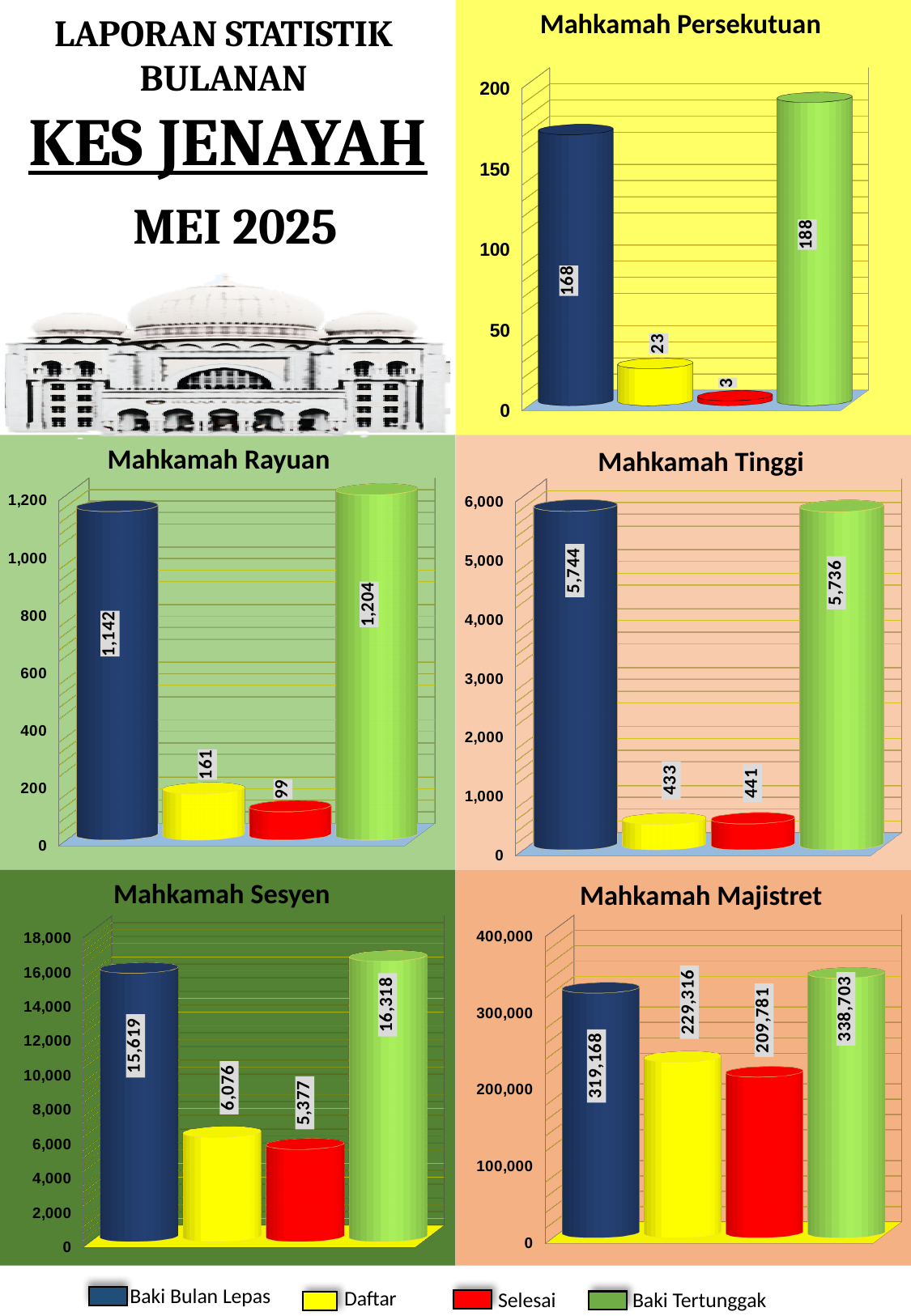
In the Mahkamah Tinggi chart, what is the value for Baki Bulan Lepas? 5,744 What kind of chart is the Mahkamah Rayuan chart? Bar chart In the Mahkamah Majistret chart, what is the value for Selesai? 209,781 In the Mahkamah Rayuan chart, what is the value for Daftar? 161 In the Mahkamah Rayuan chart, what is the difference between Baki Tertunggak and Baki Bulan Lepas? 62 How many series does the legend at the bottom of the slide list? 4 In the Mahkamah Persekutuan chart, which category has the lowest value? Selesai In the Mahkamah Sesyen chart, which category has the highest value? Baki Tertunggak In the Mahkamah Tinggi chart, which is larger, Daftar or Selesai? Selesai In the Mahkamah Majistret chart, is the value for Baki Bulan Lepas greater or less than 300,000? greater In the Mahkamah Persekutuan chart, what is the value for Baki Tertunggak? 188 In the Mahkamah Sesyen chart, what is the difference between Daftar and Selesai? 699